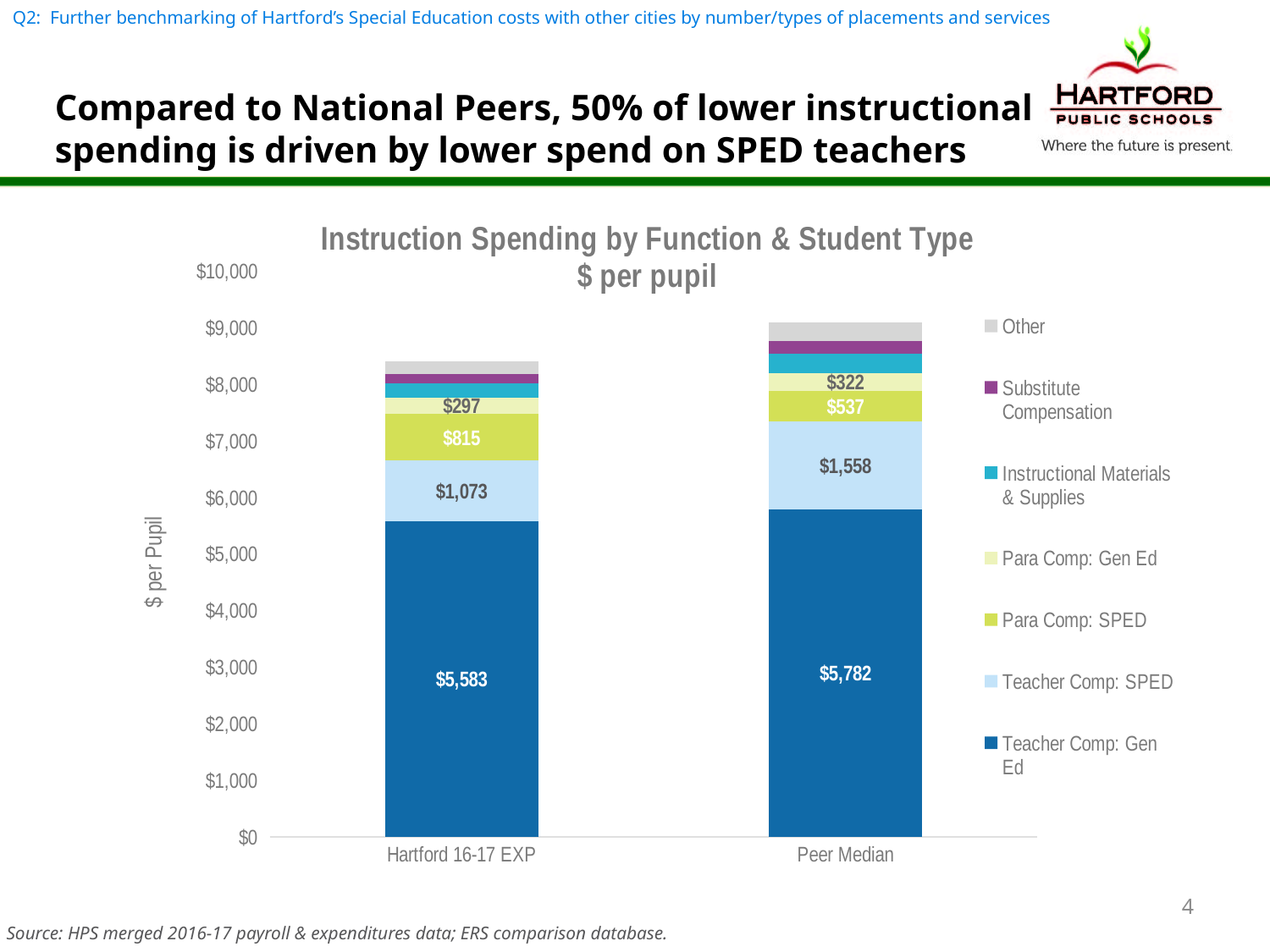
What is the Para Comp: SPED value for Hartford 16-17 EXP? $815 Is the total height of the Hartford 16-17 EXP bar greater or less than $8,000? greater What type of chart is shown on the slide? Stacked bar chart What is the difference in Teacher Comp: Gen Ed between Peer Median and Hartford 16-17 EXP? $199 What is the Teacher Comp: SPED value for Peer Median? $1,558 Which has the larger Para Comp: SPED value, Hartford 16-17 EXP or Peer Median? Hartford 16-17 EXP How many categories are shown on the x axis? 2 What is the difference in Teacher Comp: SPED between Peer Median and Hartford 16-17 EXP? $485 What is the Teacher Comp: Gen Ed value for Hartford 16-17 EXP? $5,583 How many series does the legend list? 7 What is the Para Comp: Gen Ed value for Peer Median? $322 What is the title of the chart? Instruction Spending by Function & Student Type $ per pupil